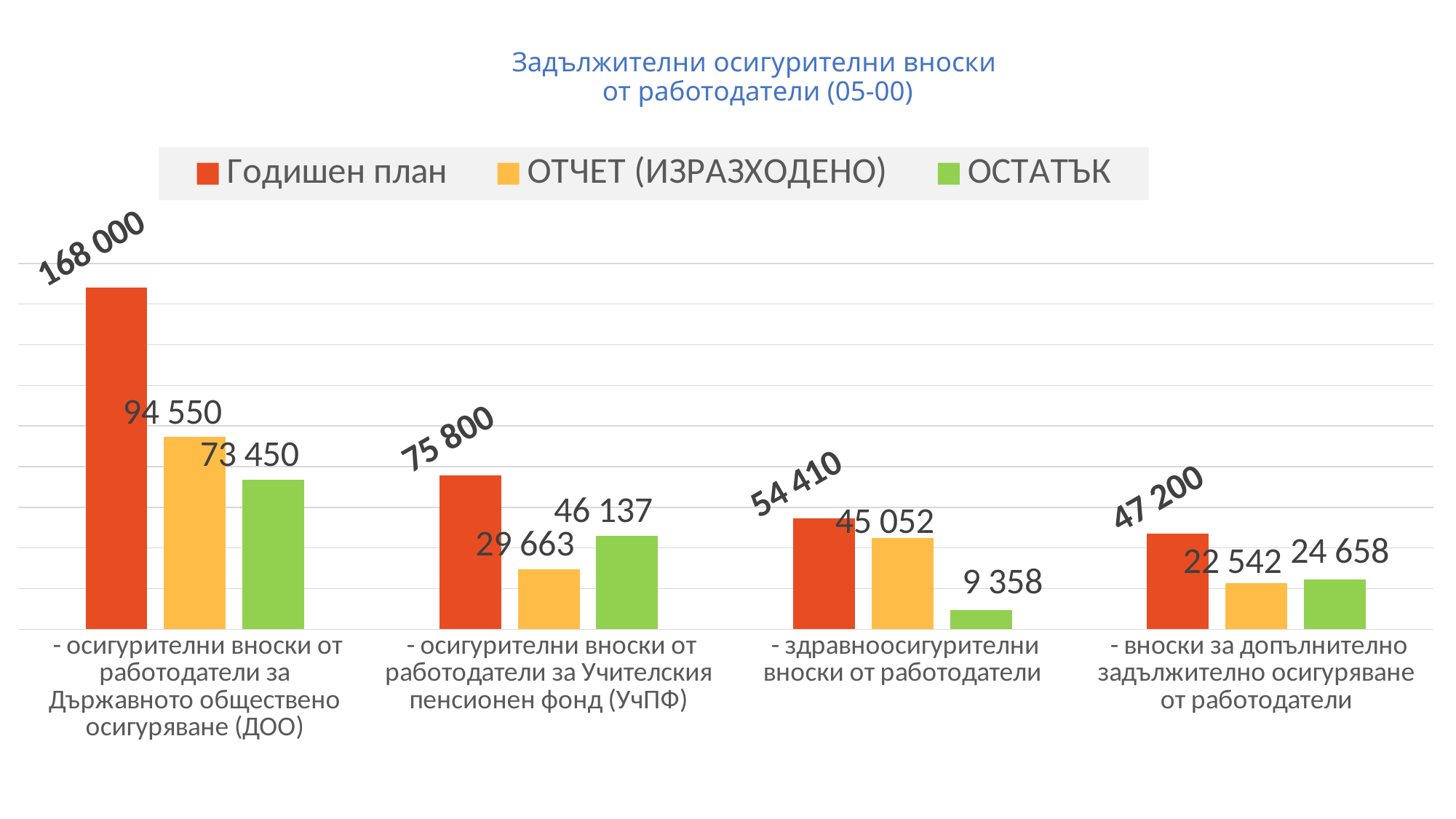
What is the ОСТАТЪК value for здравноосигурителни вноски от работодатели? 9 358 What is the ОТЧЕТ (ИЗРАЗХОДЕНО) value for вноски за допълнително задължително осигуряване от работодатели? 22 542 Which category has the lowest ОСТАТЪК value? здравноосигурителни вноски от работодатели What kind of chart is shown on the slide? bar chart Which category has the highest Годишен план value? осигурителни вноски от работодатели за Държавното обществено осигуряване (ДОО) What is the ОТЧЕТ (ИЗРАЗХОДЕНО) value for осигурителни вноски от работодатели за Учителския пенсионен фонд (УчПФ)? 29 663 What is the difference between the Годишен план and ОТЧЕТ (ИЗРАЗХОДЕНО) values for здравноосигурителни вноски от работодатели? 9 358 What is the Годишен план value for осигурителни вноски от работодатели за Държавното обществено осигуряване (ДОО)? 168 000 How many categories are shown on the x axis? 4 How many series does the legend list? 3 What colour represents the ОСТАТЪК series? green For осигурителни вноски от работодатели за Учителския пенсионен фонд (УчПФ), which is larger: ОТЧЕТ (ИЗРАЗХОДЕНО) or ОСТАТЪК? ОСТАТЪК